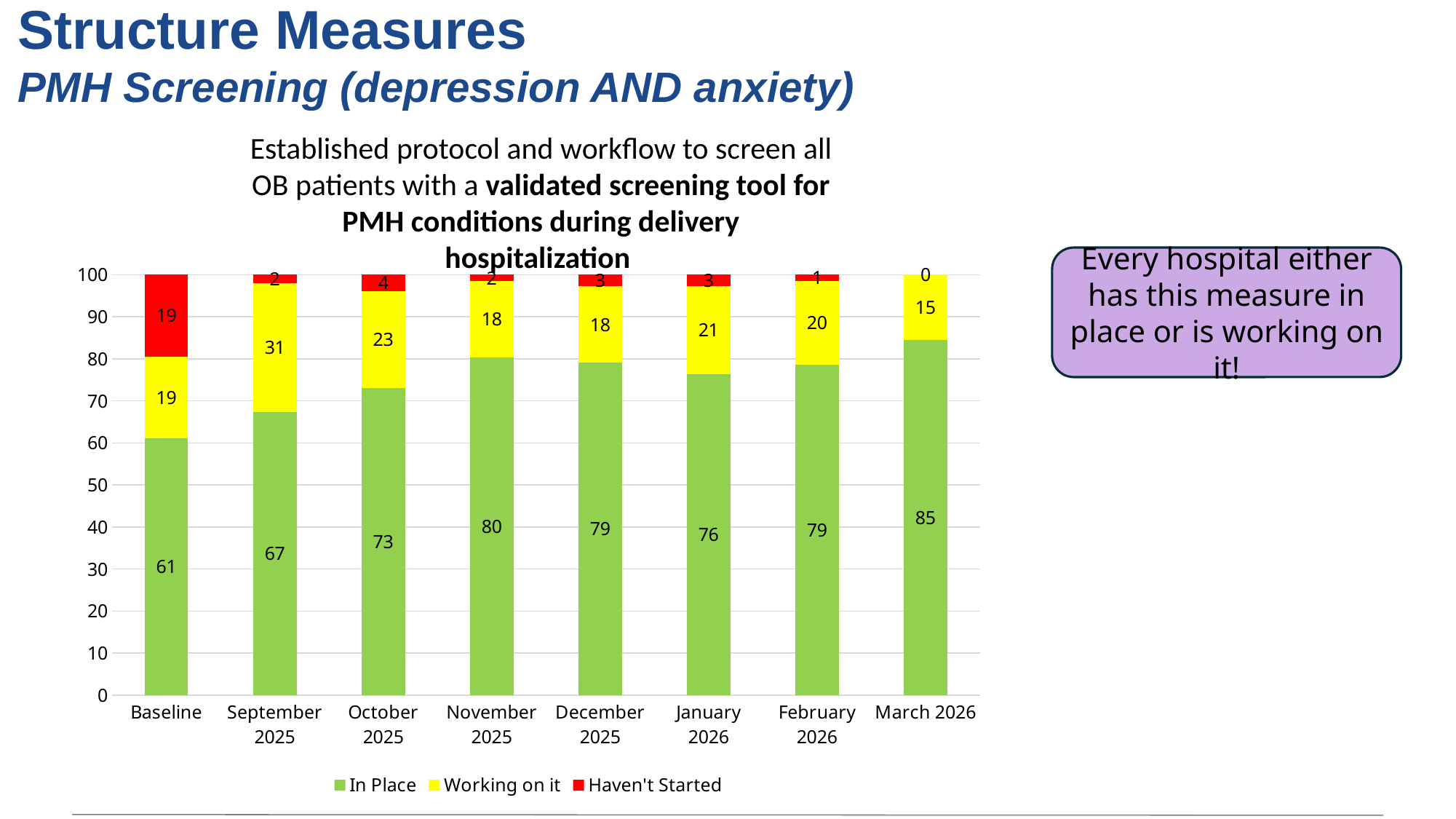
Which colour represents the "Haven't Started" series? Red What is the total of the stacked bar for October 2025? 100 How many categories are shown on the x axis? 8 Which category has the highest "In Place" value? March 2026 What is the difference between the "In Place" value for March 2026 and the "In Place" value for Baseline? 24 What is the "Working on it" value for September 2025? 31 What is the "In Place" value for November 2025? 80 What is the "Haven't Started" value for Baseline? 19 Which category has the lowest "In Place" value? Baseline How many series does the legend list? 3 What kind of chart is shown on the slide? Stacked bar chart Which is larger: the "Working on it" value for October 2025 or the "Working on it" value for January 2026? October 2025